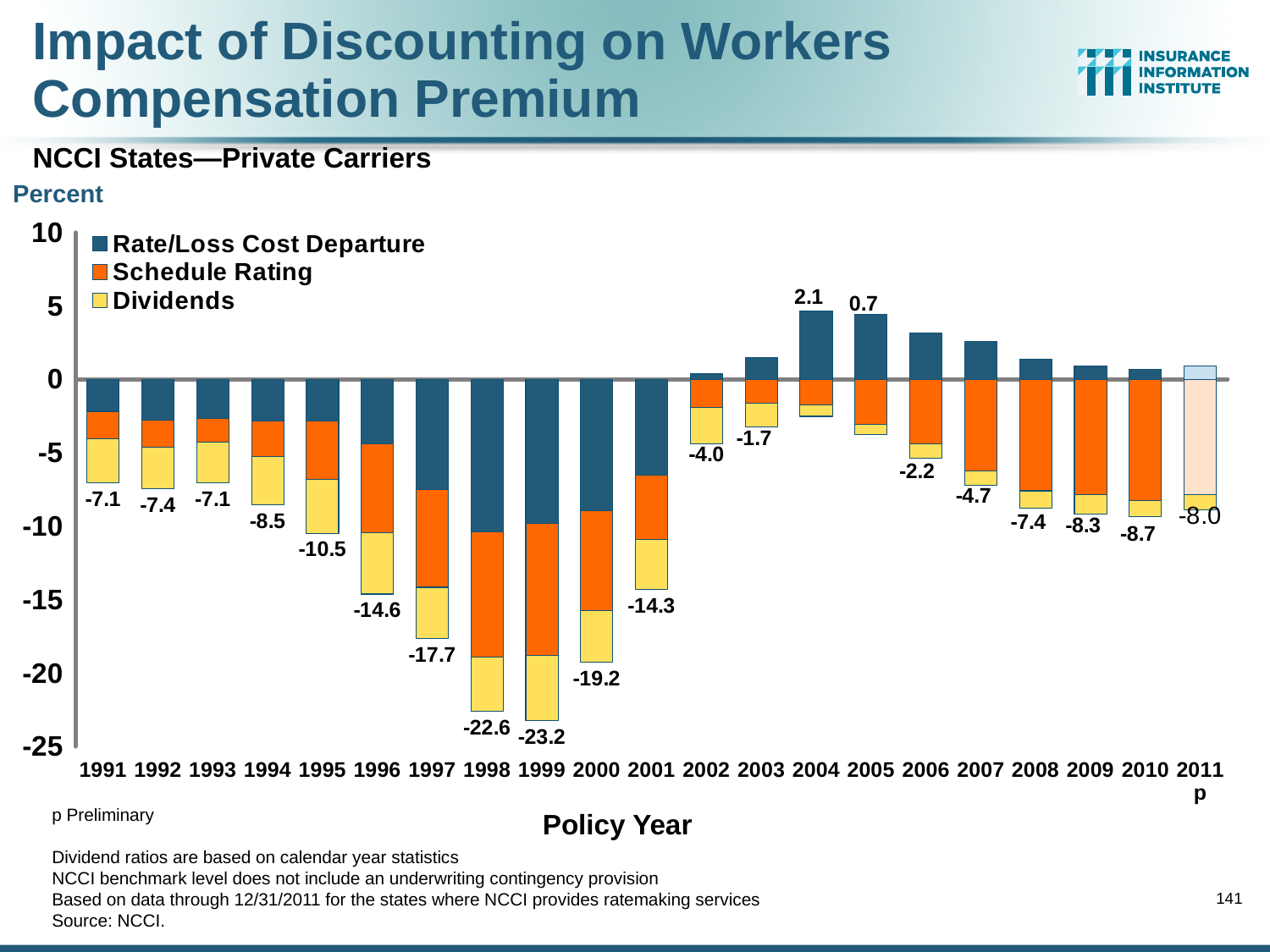
Which policy year has the highest labeled net value? 2004 How many series does the legend list? 3 What is the difference between the labeled net values for 1999 (-23.2) and 2010 (-8.7)? 14.5 Which series is shown in yellow in the legend? Dividends What is the labeled net value for policy year 1998? -22.6 Which policy year has the lowest labeled net value? 1999 What kind of chart is shown on the slide? Stacked bar chart What is the labeled net value for policy year 2011p? -8.0 What is the labeled net value for policy year 2004? 2.1 How many policy years are shown on the x axis? 21 Which policy year has a higher labeled net value, 2002 or 2006? 2006 Do the labeled net values rise or fall from 1991 to 1999? Fall